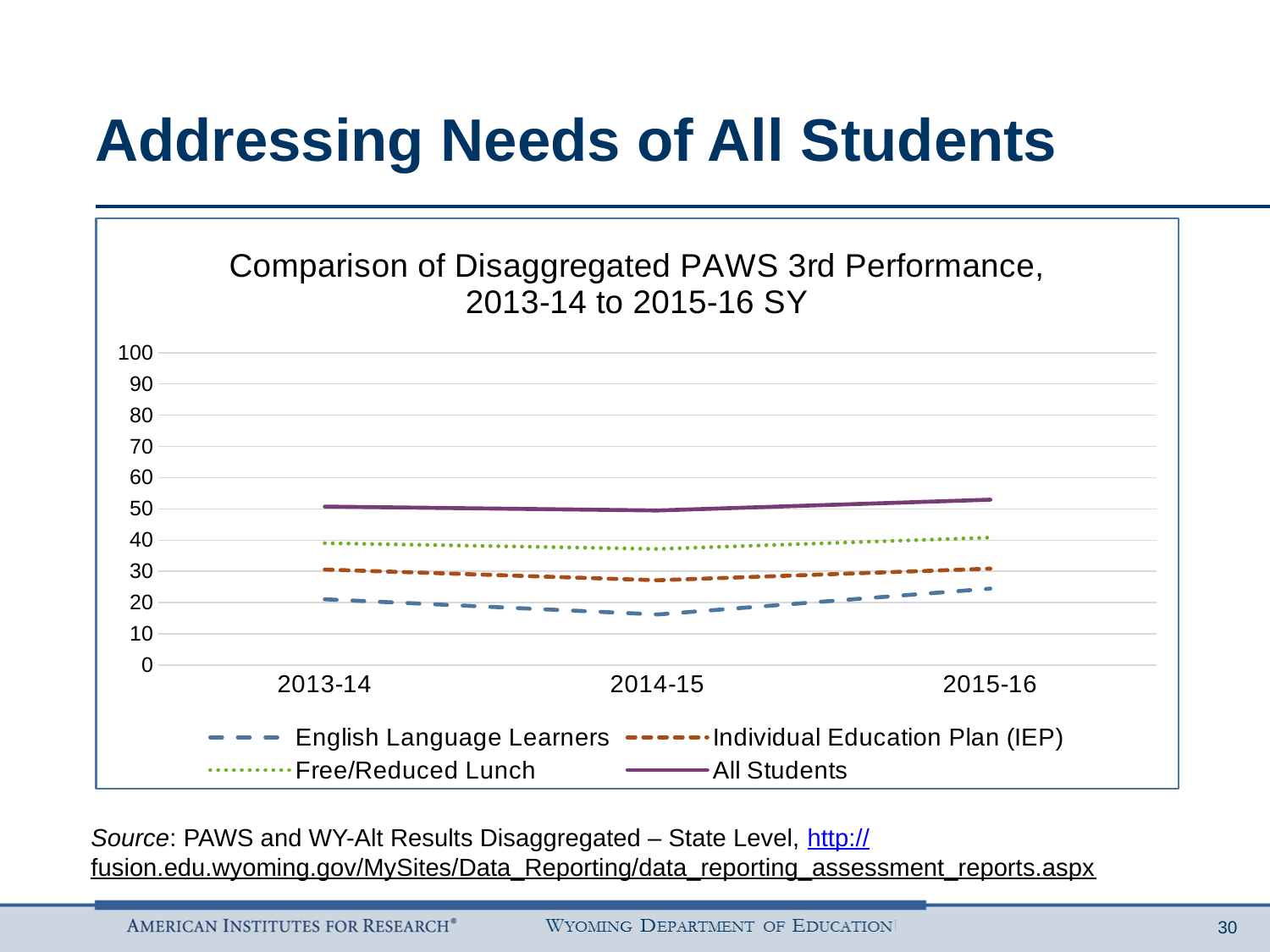
Is the value for Free/Reduced Lunch in 2015-16 greater or less than 30? greater Is the value for English Language Learners in 2015-16 greater or less than 20? greater Does the English Language Learners line rise or fall from 2014-15 to 2015-16? rise How many school years are shown on the x axis? 3 Is the value for All Students in 2013-14 greater or less than 40? greater What is the title of the chart? Comparison of Disaggregated PAWS 3rd Performance, 2013-14 to 2015-16 SY What kind of chart is shown on the slide? line chart Which series has the lowest value in 2014-15? English Language Learners How many series does the legend list? 4 Which series has the highest value in 2015-16? All Students In 2013-14, which is larger: Free/Reduced Lunch or Individual Education Plan (IEP)? Free/Reduced Lunch